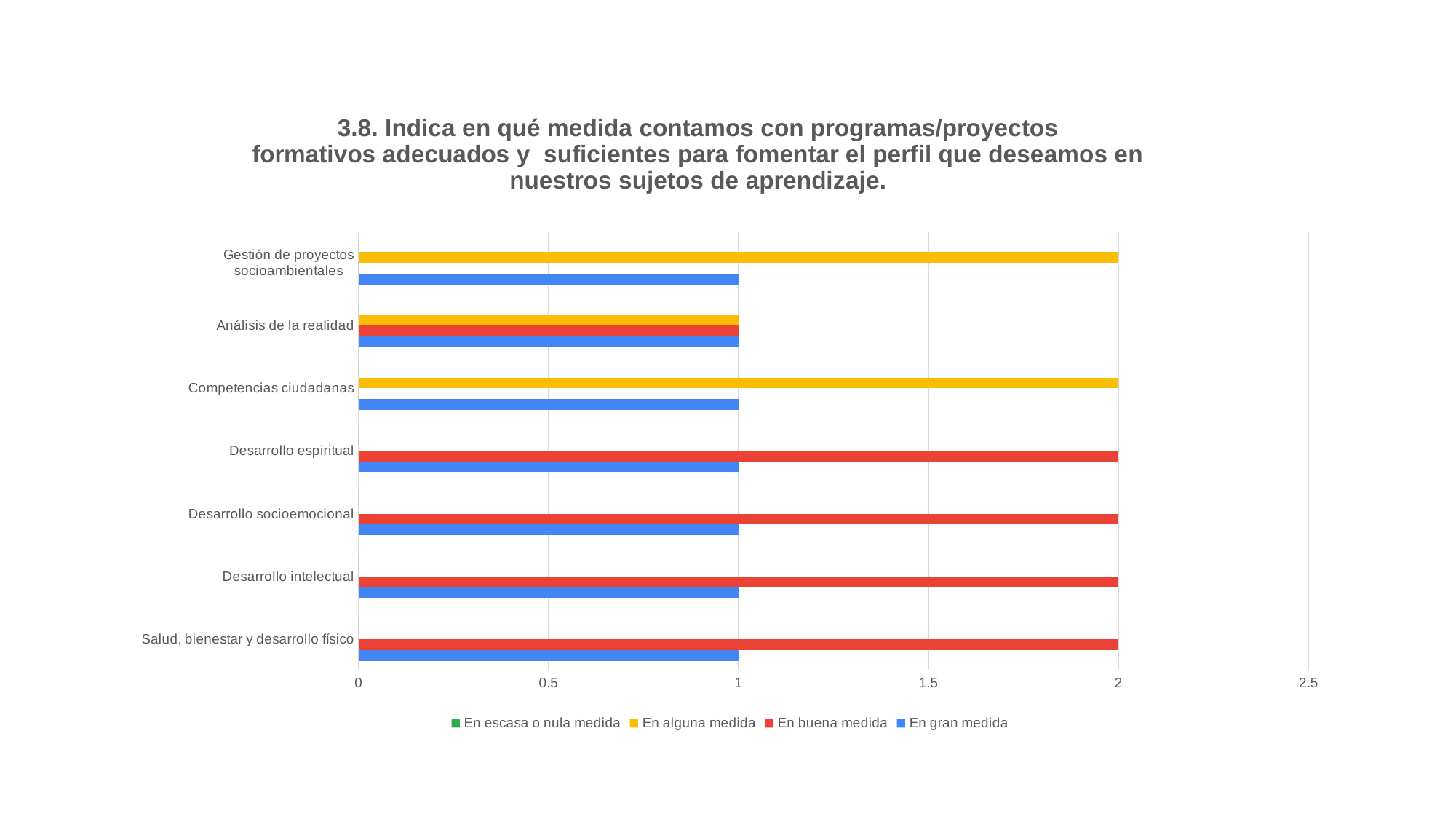
What kind of chart is shown on the slide? Bar chart Which category has a bar for 'En alguna medida', 'En buena medida' and 'En gran medida' all at the same value? Análisis de la realidad What is the value of 'En buena medida' for 'Análisis de la realidad'? 1 What is the value of 'En buena medida' for 'Salud, bienestar y desarrollo físico'? 2 How many series does the legend list? 4 What is the value of 'En alguna medida' for 'Gestión de proyectos socioambientales'? 2 What is the difference between 'En buena medida' and 'En gran medida' for 'Desarrollo intelectual'? 1 What is the value of 'En gran medida' for 'Desarrollo espiritual'? 1 How many categories are listed on the vertical axis of the chart? 7 Which legend entry is shown in green? En escasa o nula medida Is the value of 'En buena medida' for 'Desarrollo socioemocional' greater or less than 1.5? greater For 'Competencias ciudadanas', which is larger: 'En alguna medida' or 'En gran medida'? En alguna medida